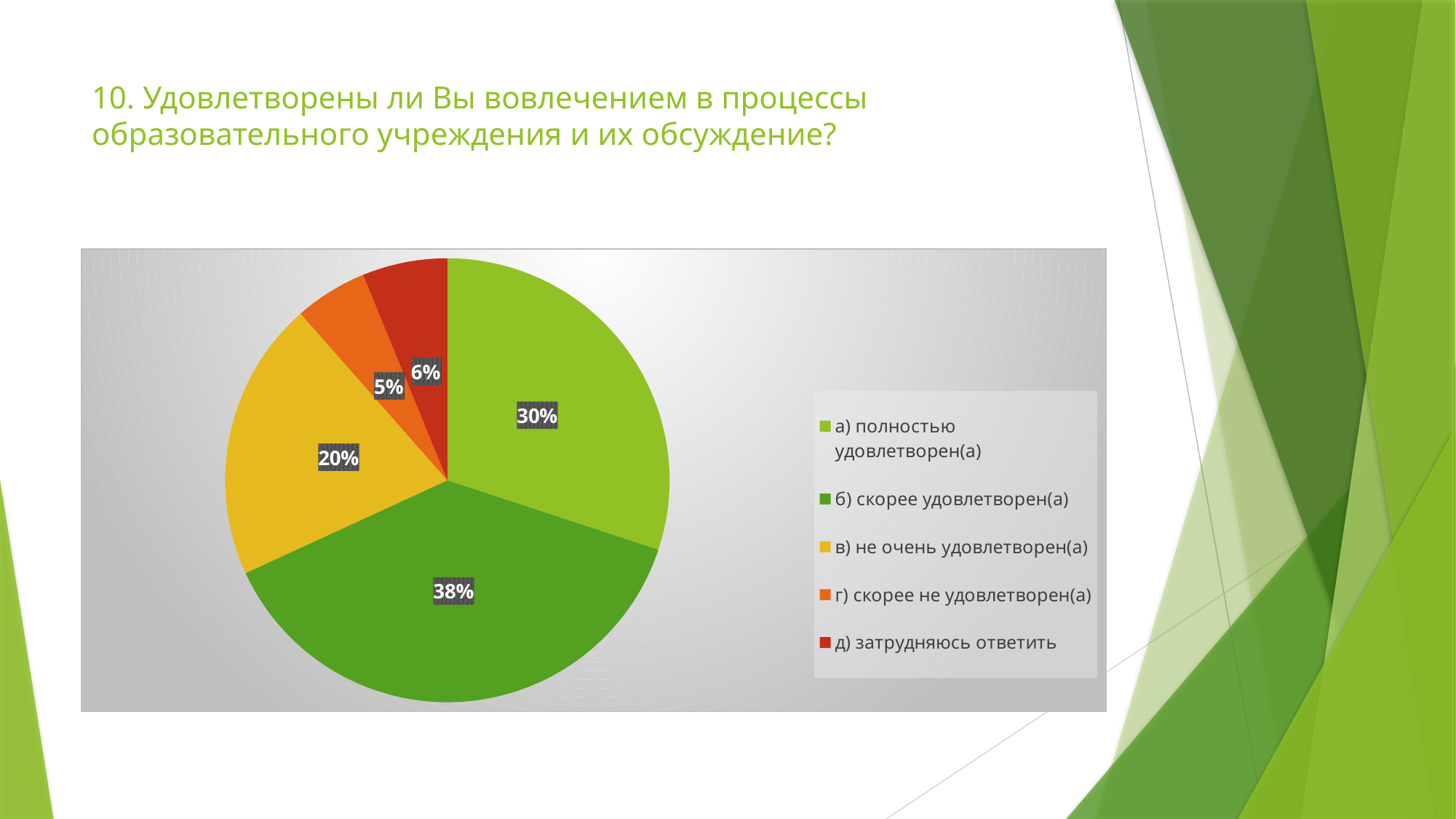
What colour is the slice for "д) затрудняюсь ответить"? red What share of the pie does "а) полностью удовлетворен(а)" have? 30% What share of the pie does "в) не очень удовлетворен(а)" have? 20% How many categories does the pie chart have? 5 What share of the pie does "г) скорее не удовлетворен(а)" have? 5% Which category has the smallest slice of the pie? г) скорее не удовлетворен(а) Which category has the largest slice of the pie? б) скорее удовлетворен(а) Which is larger: the share for "в) не очень удовлетворен(а)" or for "д) затрудняюсь ответить"? в) не очень удовлетворен(а) What is the difference between the shares of "б) скорее удовлетворен(а)" and "а) полностью удовлетворен(а)"? 8% What kind of chart is shown on the slide? pie chart